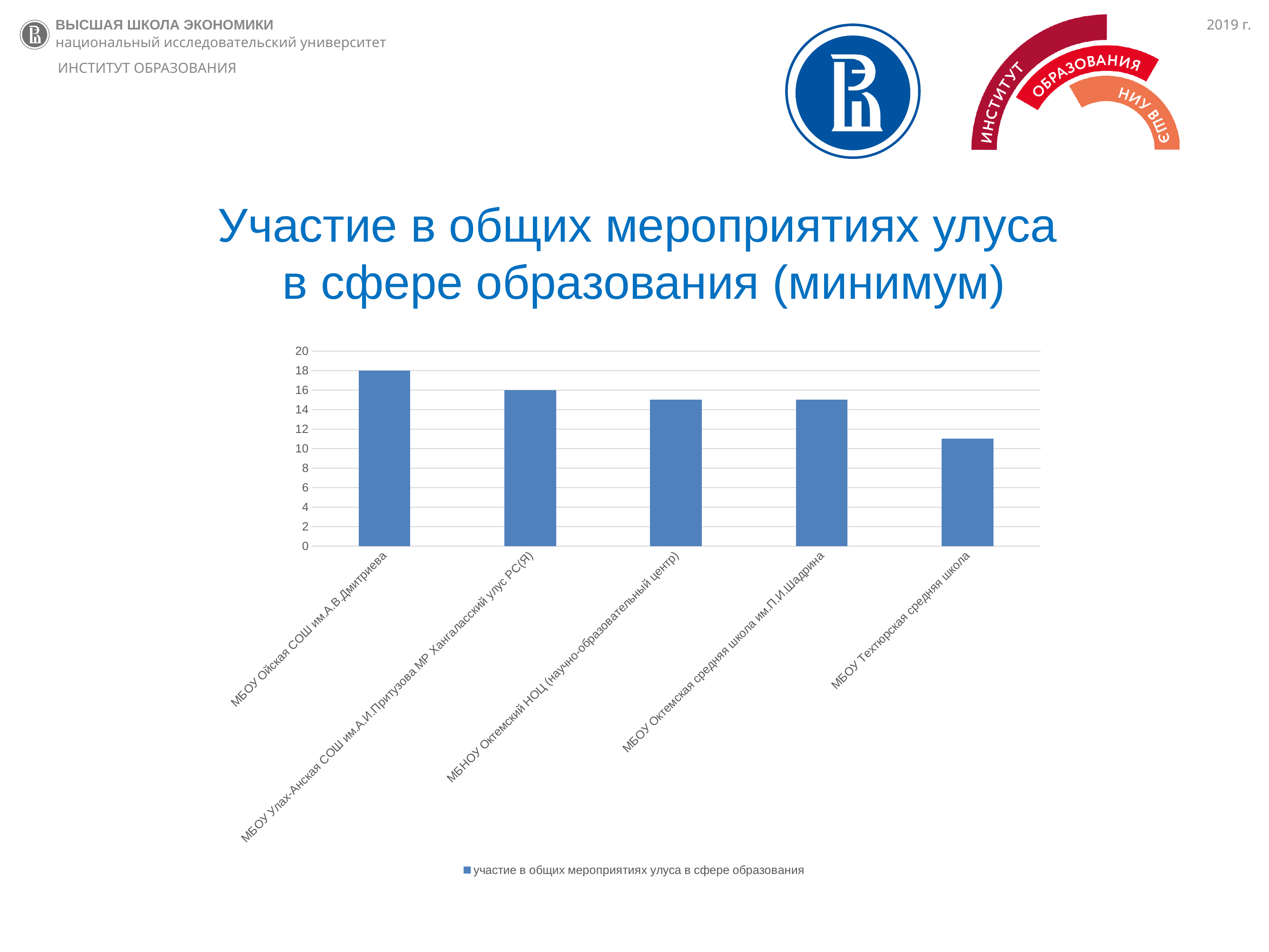
How many series does the legend list? 1 Is the value for МБОУ Техтюрская средняя школа greater or less than 12? less What is the value for МБОУ Ойская СОШ им.А.В.Дмитриева? 18 Is the value for МБНОУ Октемский НОЦ greater or less than 14? greater What kind of chart is shown on the slide? bar chart How many schools (categories) are shown on the chart? 5 Which is larger: the value for МБОУ Ойская СОШ им.А.В.Дмитриева or for МБОУ Техтюрская средняя школа? МБОУ Ойская СОШ им.А.В.Дмитриева Do the values rise or fall from left to right along the x axis? fall What is the difference between the values for МБОУ Ойская СОШ им.А.В.Дмитриева and МБОУ Улах-Анская СОШ им.А.И.Притузова? 2 What is the value for МБОУ Улах-Анская СОШ им.А.И.Притузова МР Хангаласский улус РС(Я)? 16 Which school has the lowest value on the chart? МБОУ Техтюрская средняя школа Which school has the highest value on the chart? МБОУ Ойская СОШ им.А.В.Дмитриева